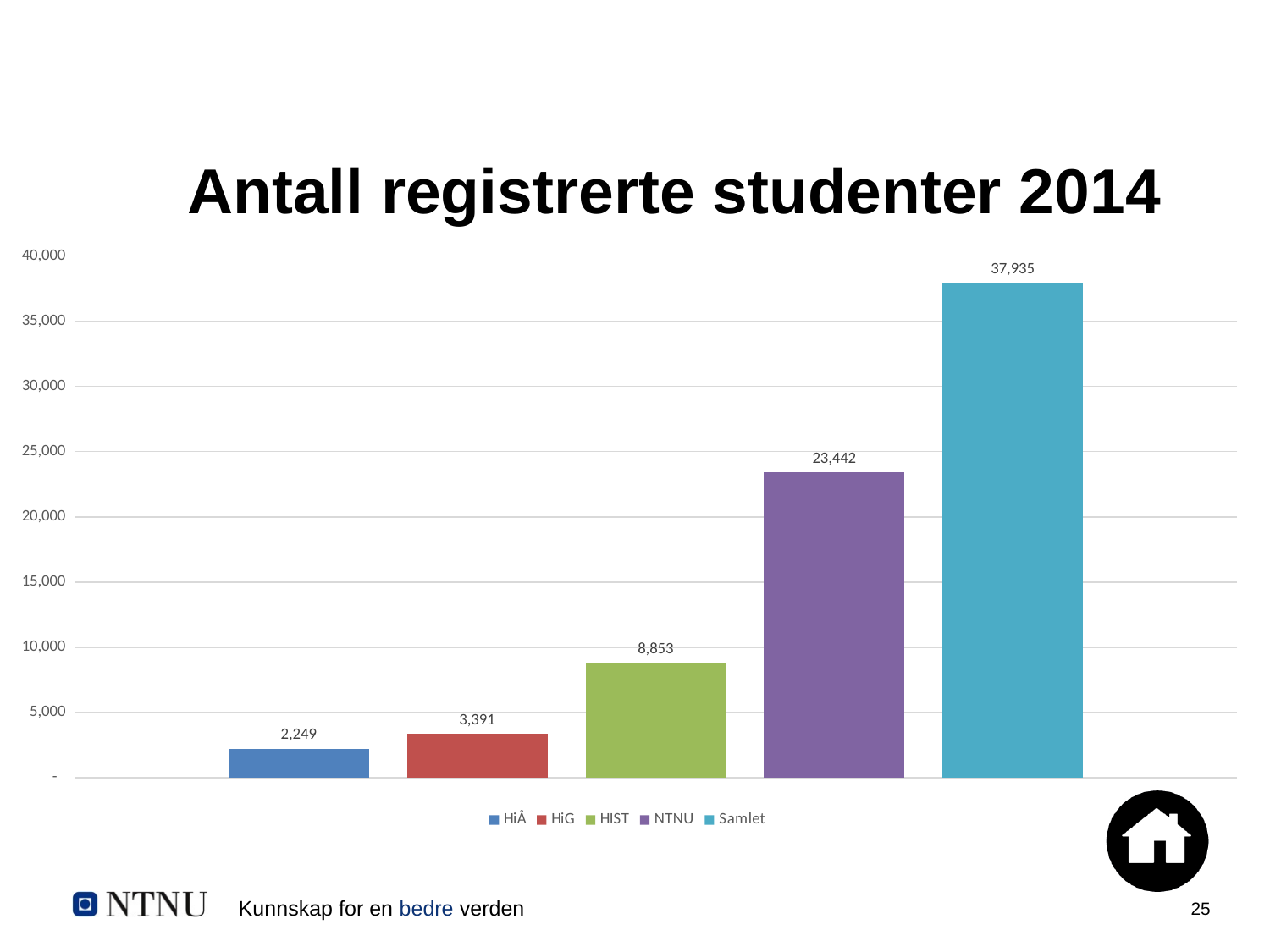
What is the title of the chart? Antall registrerte studenter 2014 Which category has the lowest value? HiÅ Is the value for Samlet greater or less than 35,000? greater What is the difference between the values for HiG and HiÅ? 1,142 What kind of chart is shown on the slide? bar chart Which category has the highest value? Samlet What is the difference between the values for NTNU and HiST? 14,589 How many bars are shown in the chart? 5 What is the value for HiST? 8,853 Which is larger, the value for HiG or the value for HiST? HiST What is the value for NTNU? 23,442 What is the value for HiÅ? 2,249